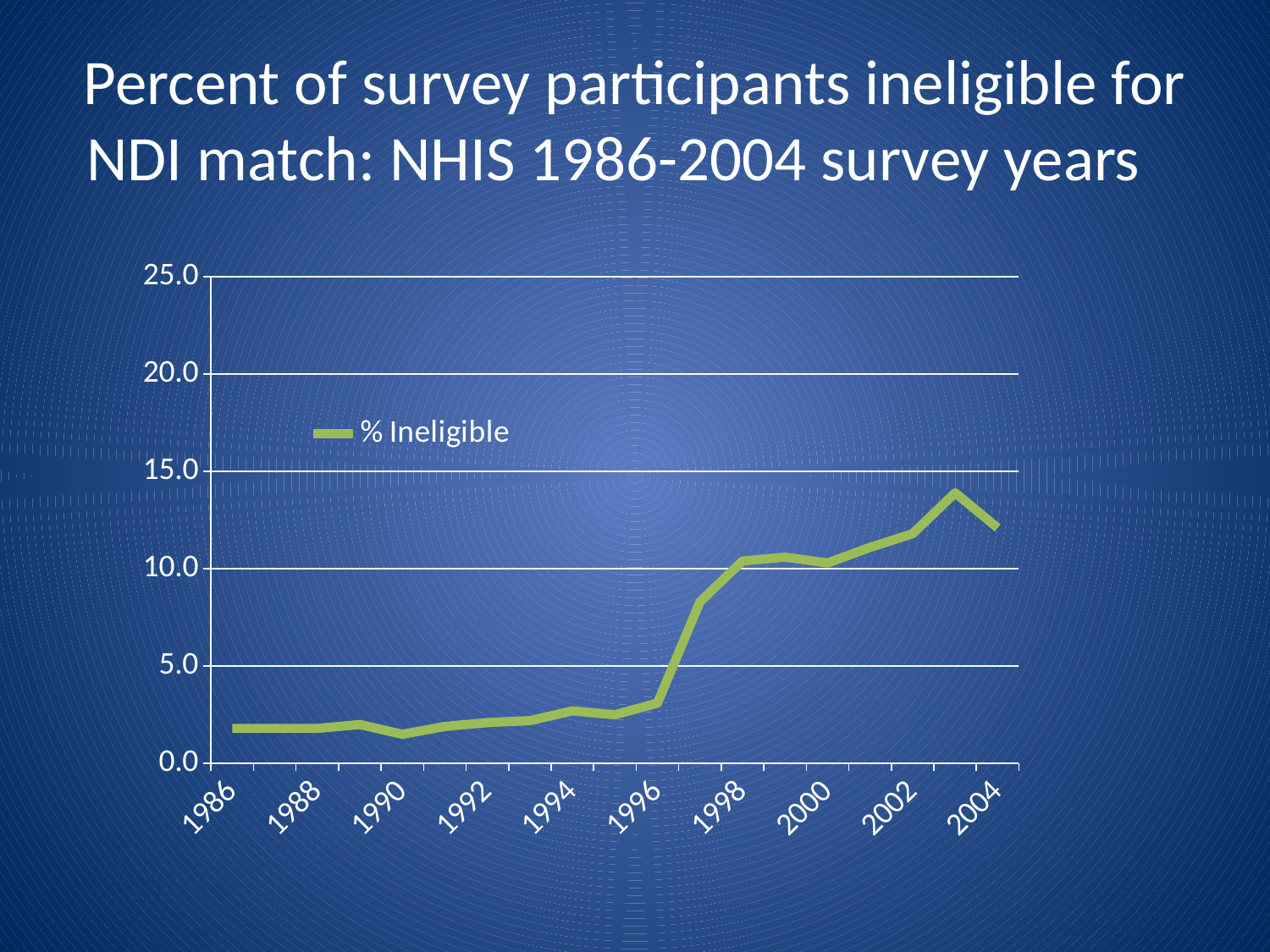
What kind of chart is shown on the slide? line chart Is the value for % Ineligible in 2003 greater or less than 15.0? less Which year has the larger value for % Ineligible, 1996 or 2003? 2003 Overall, does the % Ineligible line rise or fall from 1986 to 2004? rise What is the name of the series shown in the legend? % Ineligible Is the value for % Ineligible in 1996 greater or less than 5.0? less How many series does the legend list? 1 Is the value for % Ineligible in 1997 greater or less than 10.0? less Which year has the highest value for % Ineligible? 2003 What is the highest value shown on the vertical axis? 25.0